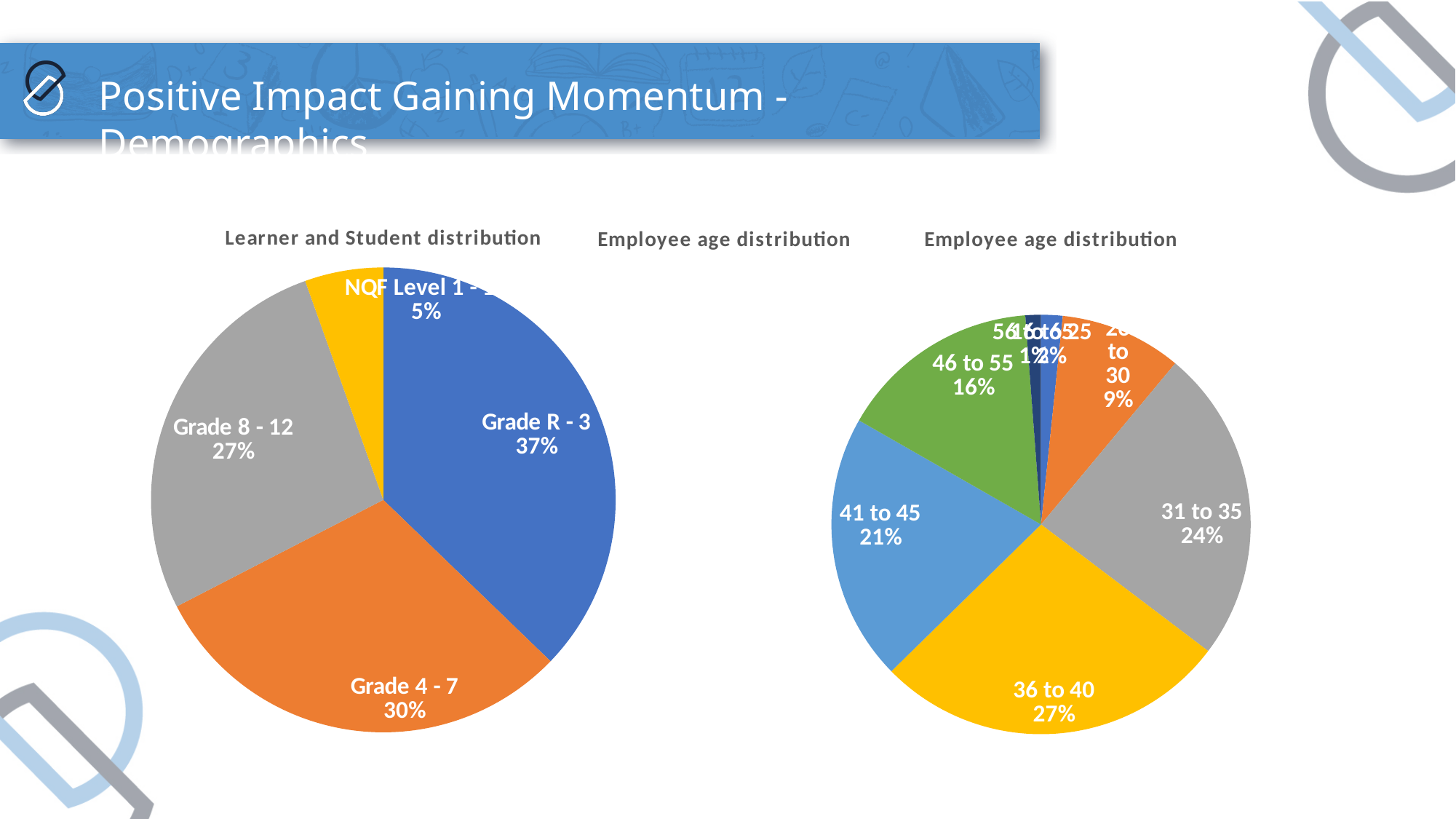
In the 'Learner and Student distribution' chart, which category has the largest share? Grade R - 3 In the 'Employee age distribution' chart, what is the difference in percentage points between the 36 to 40 and 41 to 45 groups? 6 percentage points In the 'Employee age distribution' chart, what share is the 36 to 40 age group? 27% In the 'Learner and Student distribution' chart, what share is Grade 4 - 7? 30% In the 'Employee age distribution' chart, which age group has the largest share? 36 to 40 In the 'Employee age distribution' chart, what share is the 46 to 55 age group? 16% In the 'Learner and Student distribution' chart, what share is Grade R - 3? 37% How many slices does the 'Learner and Student distribution' pie chart have? 4 In the 'Learner and Student distribution' chart, how many percentage points larger is Grade R - 3 than Grade 8 - 12? 10 percentage points In the 'Employee age distribution' chart, which is larger: 41 to 45 or 46 to 55? 41 to 45 In the 'Employee age distribution' chart, what share is the 31 to 35 age group? 24% What kind of chart is the 'Learner and Student distribution' chart? Pie chart